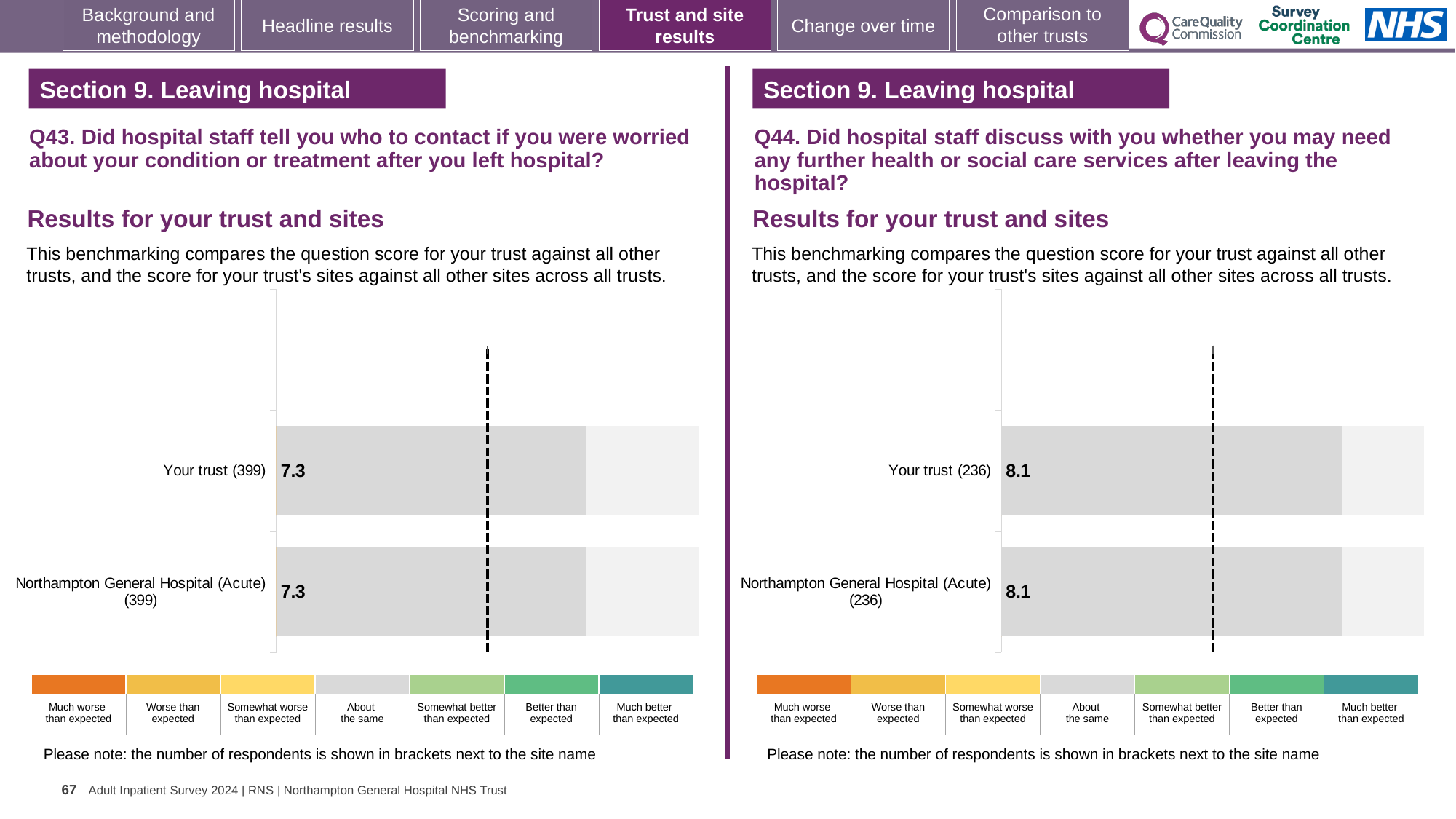
How many bars are plotted in the Q44 chart on the right? 2 In the Q43 chart on the left, what is the score for Northampton General Hospital (Acute)? 7.3 In the Q44 chart on the right, what is the difference between the score for Your trust and the score for Northampton General Hospital (Acute)? 0.0 How many respondents are shown in brackets for Your trust in the Q44 chart on the right? 236 How many respondents are shown in brackets for Your trust in the Q43 chart on the left? 399 In the Q43 chart on the left, what is the difference between the score for Your trust and the score for Northampton General Hospital (Acute)? 0.0 In the Q43 chart on the left, what is the score for Your trust? 7.3 In the Q44 chart on the right, what is the score for Your trust? 8.1 How many benchmark categories does the colour key below each chart list? 7 In the Q44 chart on the right, what is the score for Northampton General Hospital (Acute)? 8.1 What kind of chart is used for the Q43 results on the left? Bar chart How many bars are plotted in the Q43 chart on the left? 2